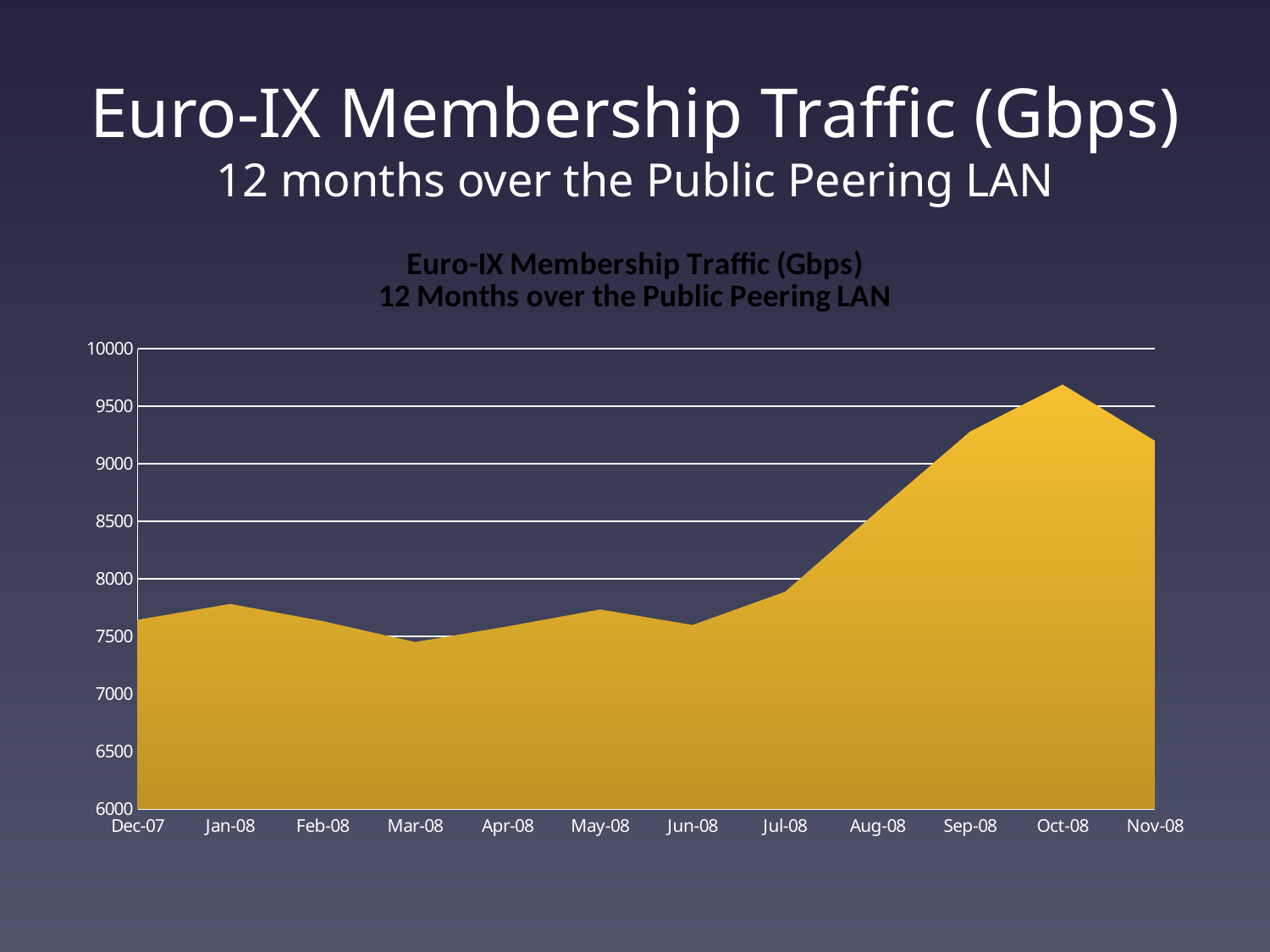
Which is larger, the value for Oct-08 or the value for Nov-08? Oct-08 Which month has the lowest traffic value? Mar-08 What kind of chart is shown on the slide? Area chart Is the value for Oct-08 greater or less than 9500? greater Which month has the highest traffic value? Oct-08 Is the value for Sep-08 greater or less than 9000? greater Do the values rise or fall from Jul-08 to Oct-08? rise How many months are plotted along the x axis? 12 What is the first line of the chart's title? Euro-IX Membership Traffic (Gbps) Is the value for Jul-08 greater or less than 8000? less